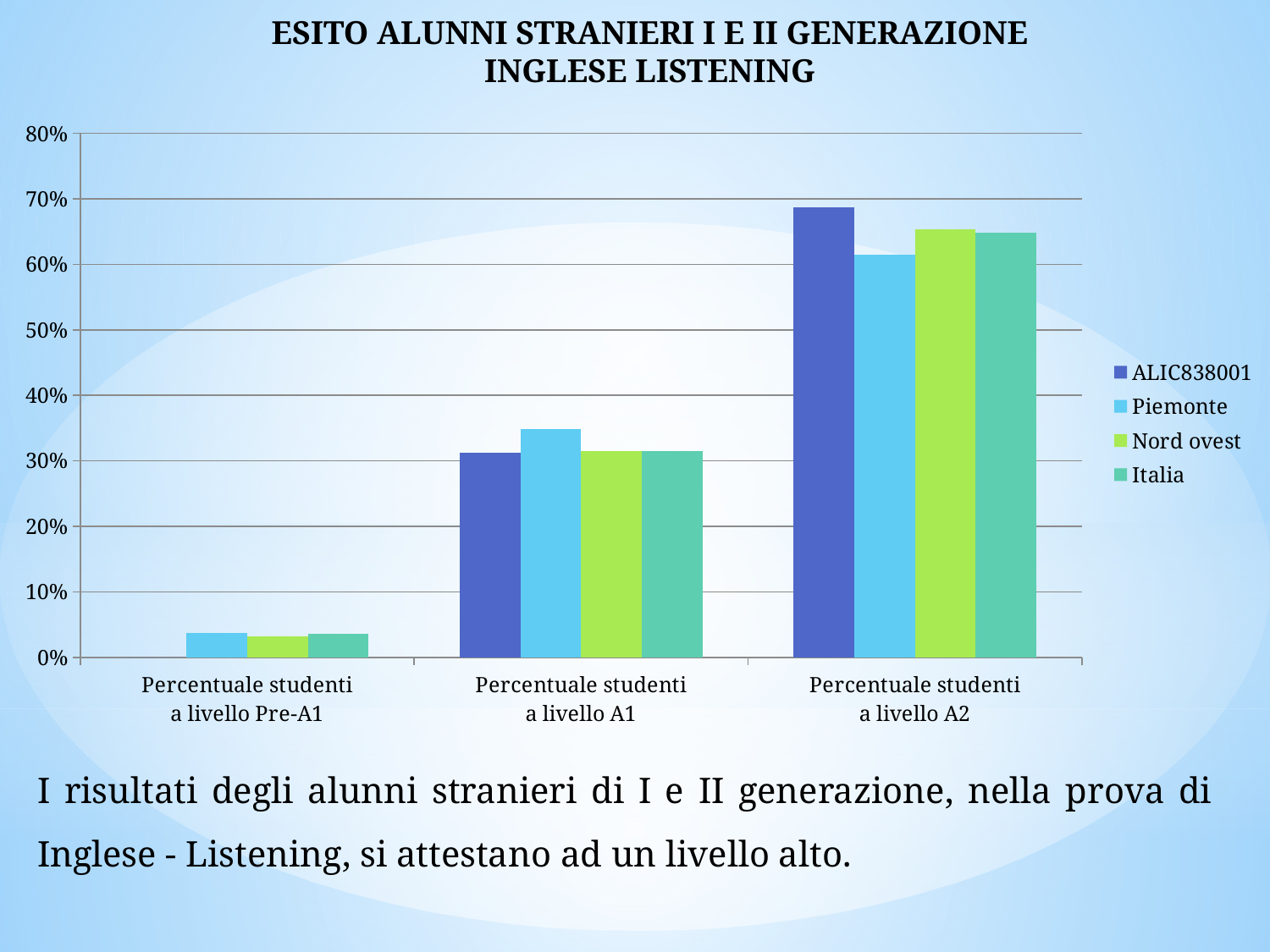
What kind of chart is shown on the slide? bar chart Which series has the highest value at 'Percentuale studenti a livello A1'? Piemonte Which series has the highest value at 'Percentuale studenti a livello A2'? ALIC838001 How many categories are shown on the x axis? 3 Is the value for ALIC838001 at 'Percentuale studenti a livello A2' greater or less than 60%? greater Is the value for Piemonte at 'Percentuale studenti a livello A1' greater or less than 30%? greater At 'Percentuale studenti a livello A2', which is larger: ALIC838001 or Piemonte? ALIC838001 Which series has the lowest value at 'Percentuale studenti a livello A2'? Piemonte How many series does the legend list? 4 Is the value for Piemonte at 'Percentuale studenti a livello Pre-A1' greater or less than 10%? less Do the values for Italia rise or fall from Pre-A1 to A2 along the x axis? rise